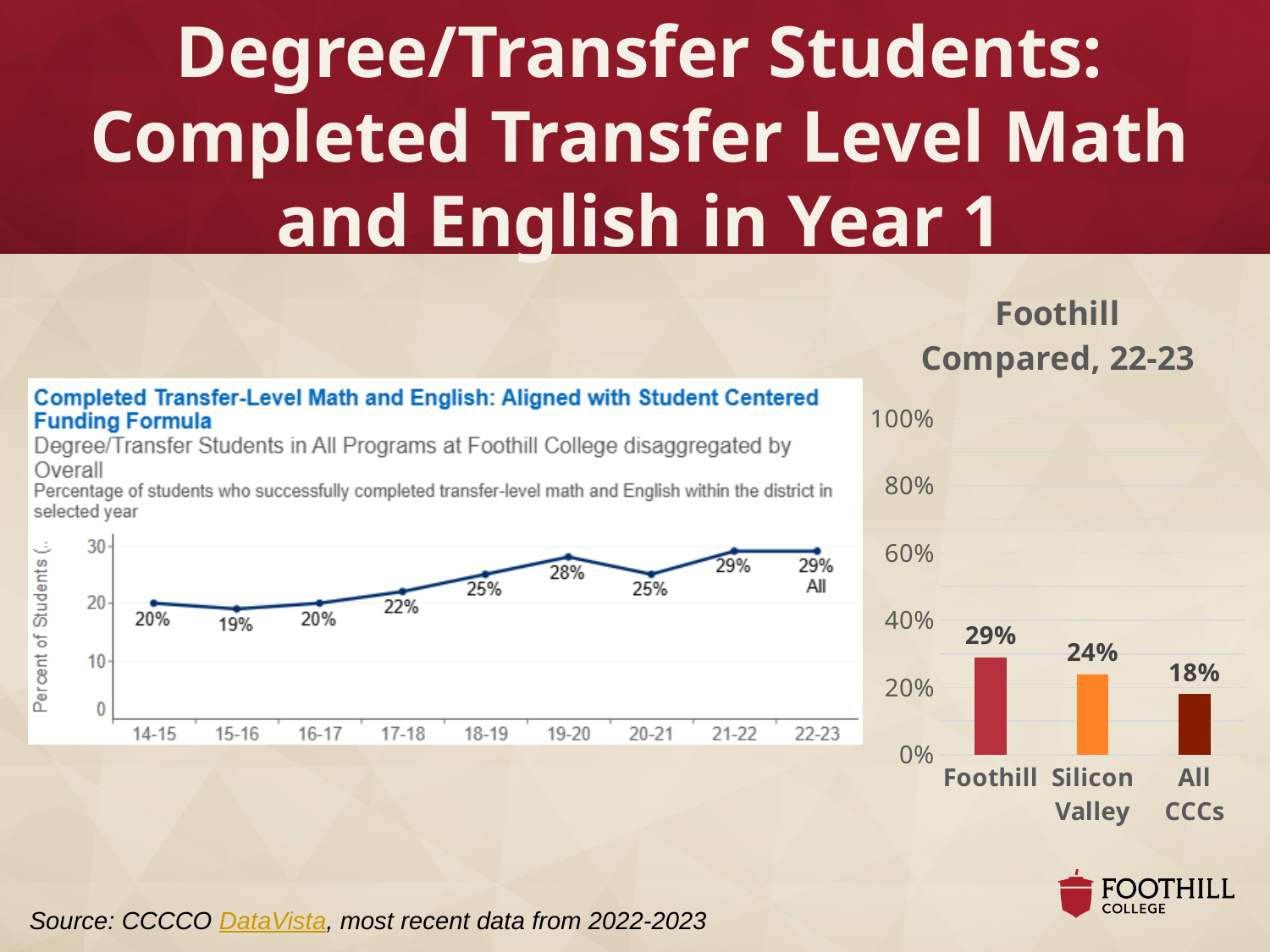
In the line chart on the left, what is the value for 15-16? 19% In the 'Foothill Compared, 22-23' chart, what is the difference between Foothill and All CCCs? 11% What kind of chart is the 'Foothill Compared, 22-23' chart? bar chart In the line chart on the left, is the value for 17-18 larger or smaller than the value for 18-19? smaller In the line chart on the left, which year has the lowest value? 15-16 In the line chart on the left, how many years are plotted? 9 In the 'Foothill Compared, 22-23' chart, what is the value for Silicon Valley? 24% In the line chart on the left, what is the value for 19-20? 28% In the 'Foothill Compared, 22-23' chart, which category has the lowest value? All CCCs In the 'Foothill Compared, 22-23' chart, how many categories are shown? 3 In the line chart on the left, what is the difference between the 22-23 value and the 14-15 value? 9% In the line chart on the left, do the values generally rise or fall from 14-15 to 22-23? rise